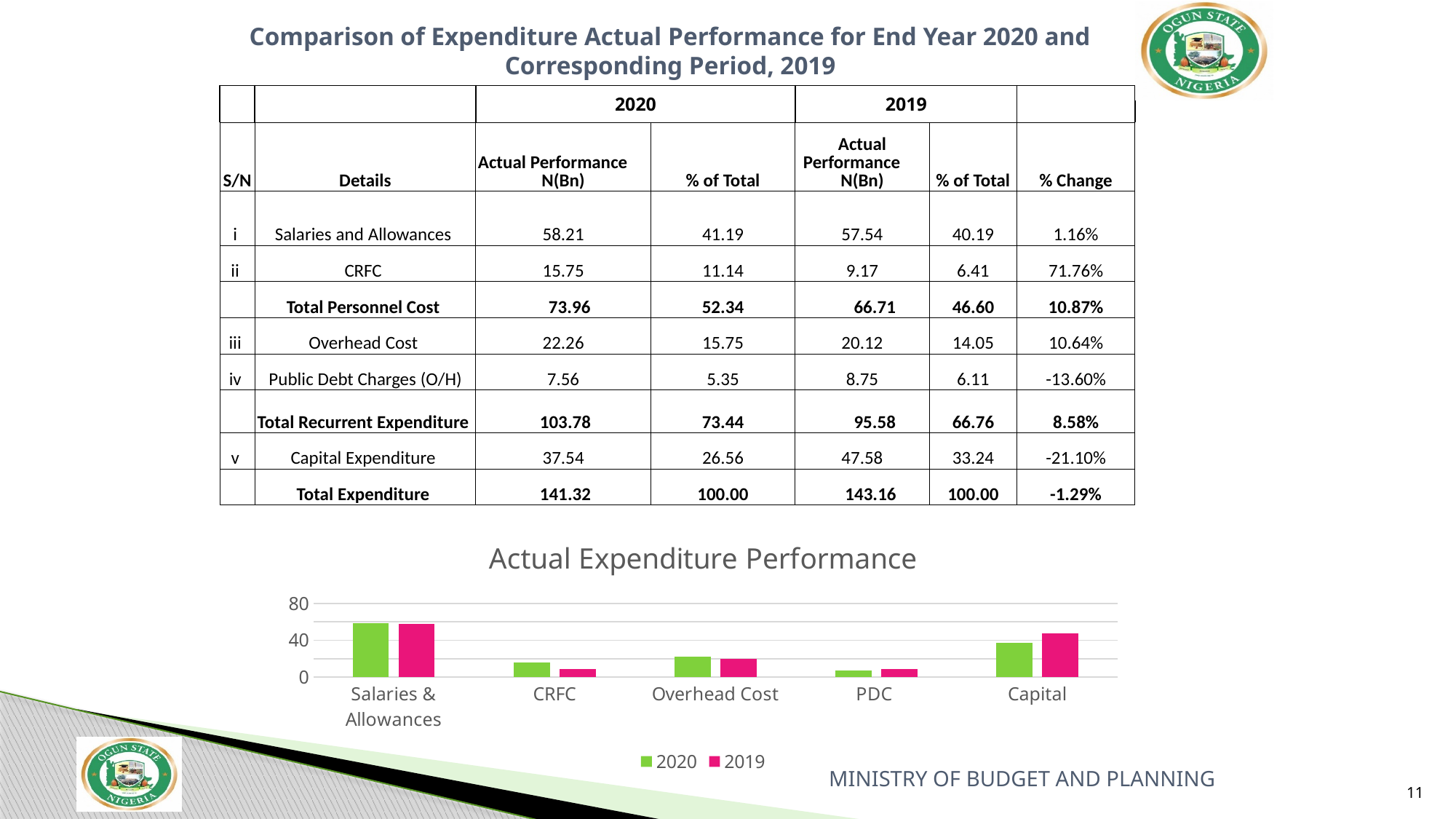
What kind of chart is the 'Actual Expenditure Performance' chart? bar chart In the 'Actual Expenditure Performance' chart, which category has the highest 2020 bar? Salaries & Allowances In the 'Actual Expenditure Performance' chart, which is larger for Capital: the 2020 value or the 2019 value? 2019 In the 'Actual Expenditure Performance' chart, is the 2020 value for Salaries & Allowances greater or less than 40? greater How many categories are shown on the x axis of the 'Actual Expenditure Performance' chart? 5 How many series does the legend of the 'Actual Expenditure Performance' chart list? 2 In the 'Actual Expenditure Performance' chart, which is larger for CRFC: the 2020 value or the 2019 value? 2020 In the 'Actual Expenditure Performance' chart, which category has the lowest 2020 bar? PDC In the 'Actual Expenditure Performance' chart, is the 2020 value for CRFC greater or less than 40? less In the 'Actual Expenditure Performance' chart, which category has the highest 2019 bar? Salaries & Allowances In the 'Actual Expenditure Performance' chart, which colour represents the 2019 series? pink In the 'Actual Expenditure Performance' chart, is the 2019 value for Capital greater or less than 40? greater